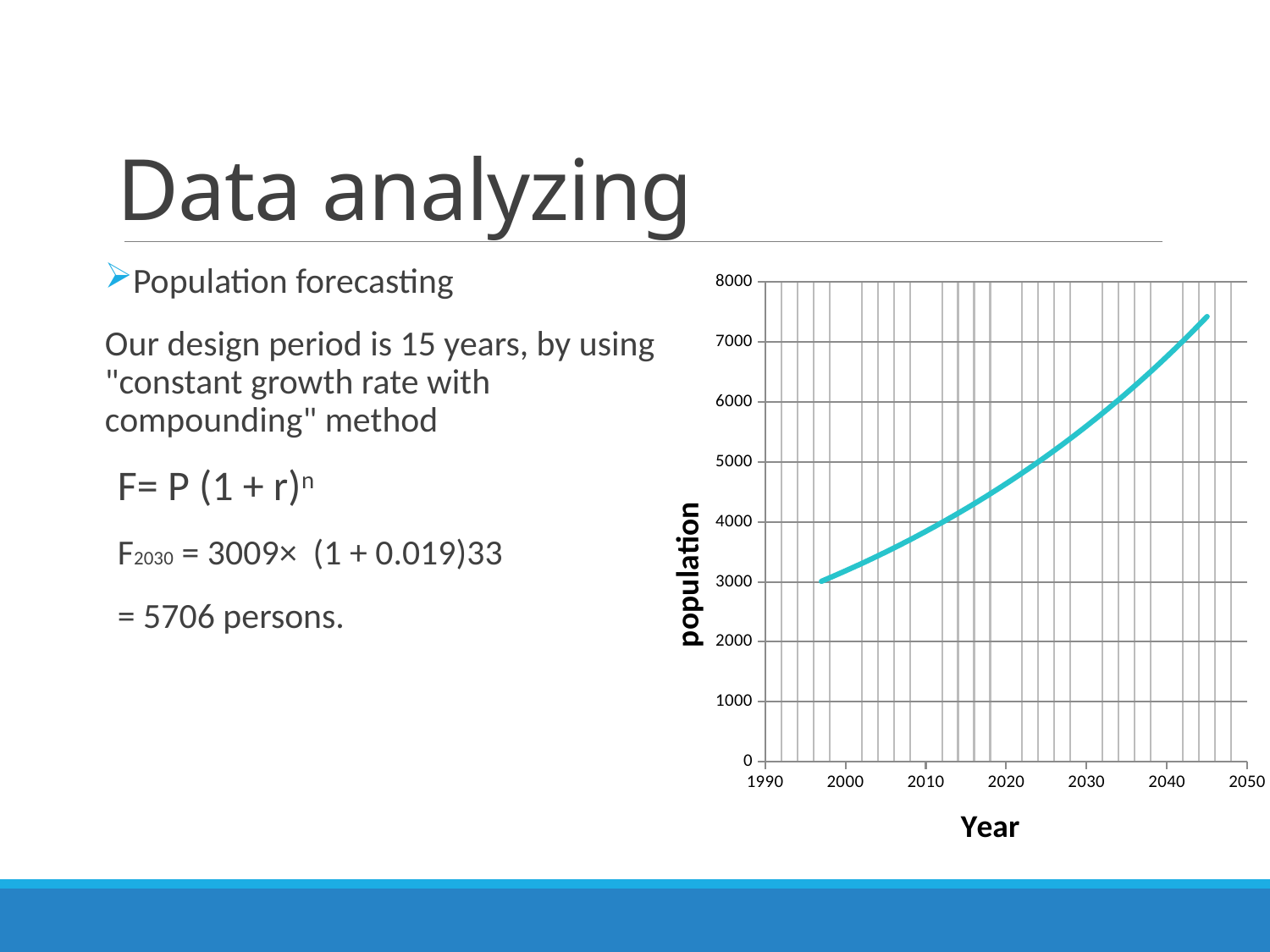
What is the label of the y axis of the chart? population Does the population rise or fall as the year increases along the x axis? rise Is the population value at 2030 greater or less than 5000? greater Is the population value at 2020 greater or less than 4000? greater Is the population value at 2020 greater or less than 5000? less What kind of chart is shown on the slide? line chart Which is larger, the population at 2010 or the population at 2040? 2040 What is the label of the x axis of the chart? Year